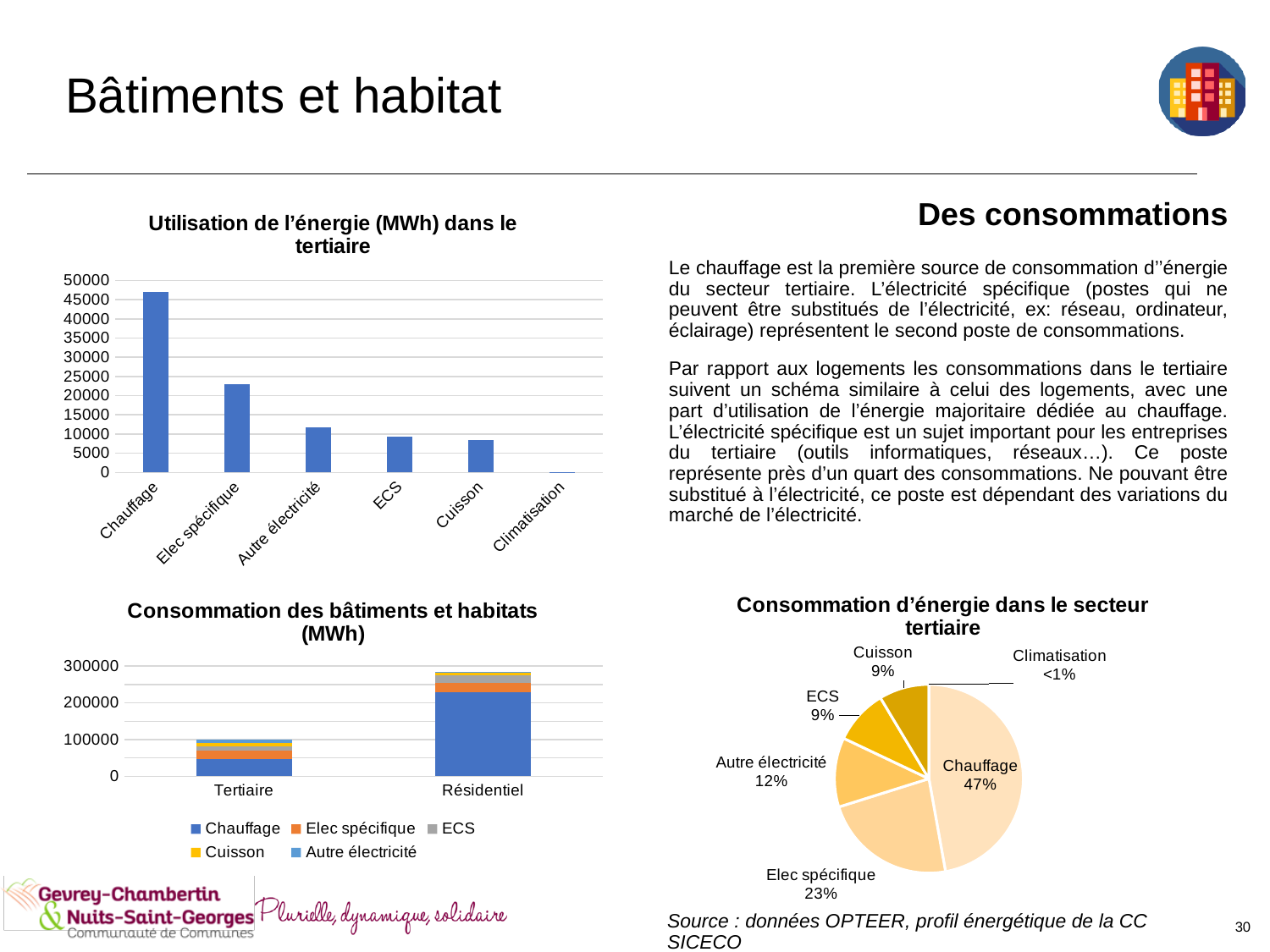
In the bar chart 'Utilisation de l'énergie (MWh) dans le tertiaire', how many categories are shown on the x axis? 6 In the pie chart 'Consommation d'énergie dans le secteur tertiaire', how many percentage points larger is the Chauffage share than the Elec spécifique share? 24 percentage points In the chart 'Consommation des bâtiments et habitats (MWh)', is the total for Résidentiel greater or less than 200000? greater In the chart 'Consommation des bâtiments et habitats (MWh)', how many series does the legend list? 5 In the pie chart 'Consommation d'énergie dans le secteur tertiaire', which category has the smallest slice? Climatisation In the bar chart 'Utilisation de l'énergie (MWh) dans le tertiaire', which category has the highest value? Chauffage In the pie chart 'Consommation d'énergie dans le secteur tertiaire', how many slices are there? 6 In the bar chart 'Utilisation de l'énergie (MWh) dans le tertiaire', is the value for Chauffage greater or less than 40000? greater In the bar chart 'Utilisation de l'énergie (MWh) dans le tertiaire', is the value for Elec spécifique greater or less than 25000? less In the pie chart 'Consommation d'énergie dans le secteur tertiaire', what share does Elec spécifique represent? 23% In the pie chart 'Consommation d'énergie dans le secteur tertiaire', which category has the largest slice? Chauffage In the pie chart 'Consommation d'énergie dans le secteur tertiaire', what share does Chauffage represent? 47%